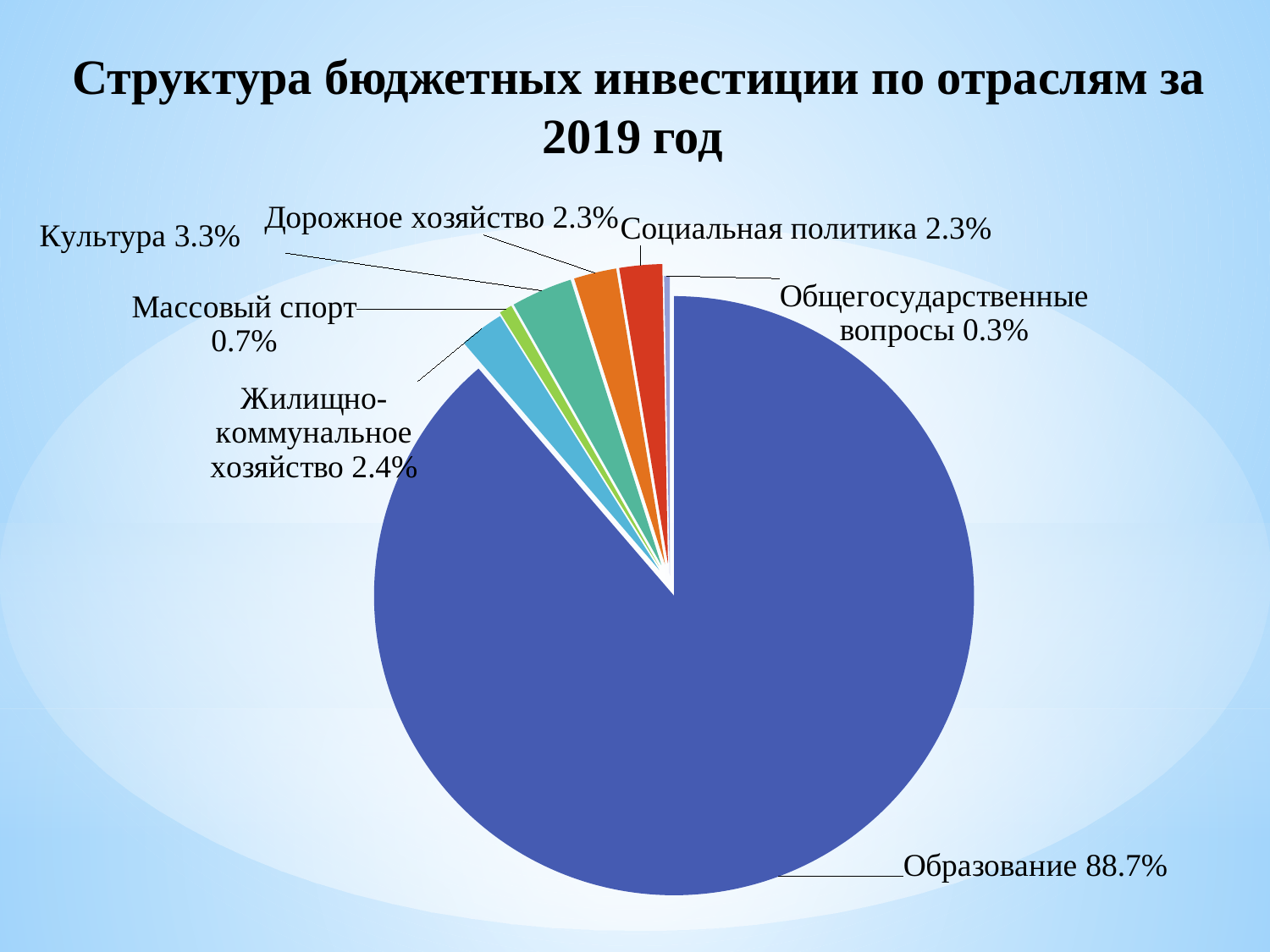
What percentage is shown for Жилищно-коммунальное хозяйство? 2.4% How many sectors are shown in the pie chart? 7 What is the difference in percentage points between Образование and Культура? 85.4 What type of chart is shown on the slide? Pie chart What share of budget investments does Образование account for? 88.7% What is the value shown for Культура? 3.3% Which sector has the largest share of budget investments? Образование What is the difference in percentage points between Культура and Жилищно-коммунальное хозяйство? 0.9 Which is larger, the share for Культура or the share for Дорожное хозяйство? Культура Which sector has the smallest share of budget investments? Общегосударственные вопросы What share is shown for Общегосударственные вопросы? 0.3% What is the value for Массовый спорт? 0.7%